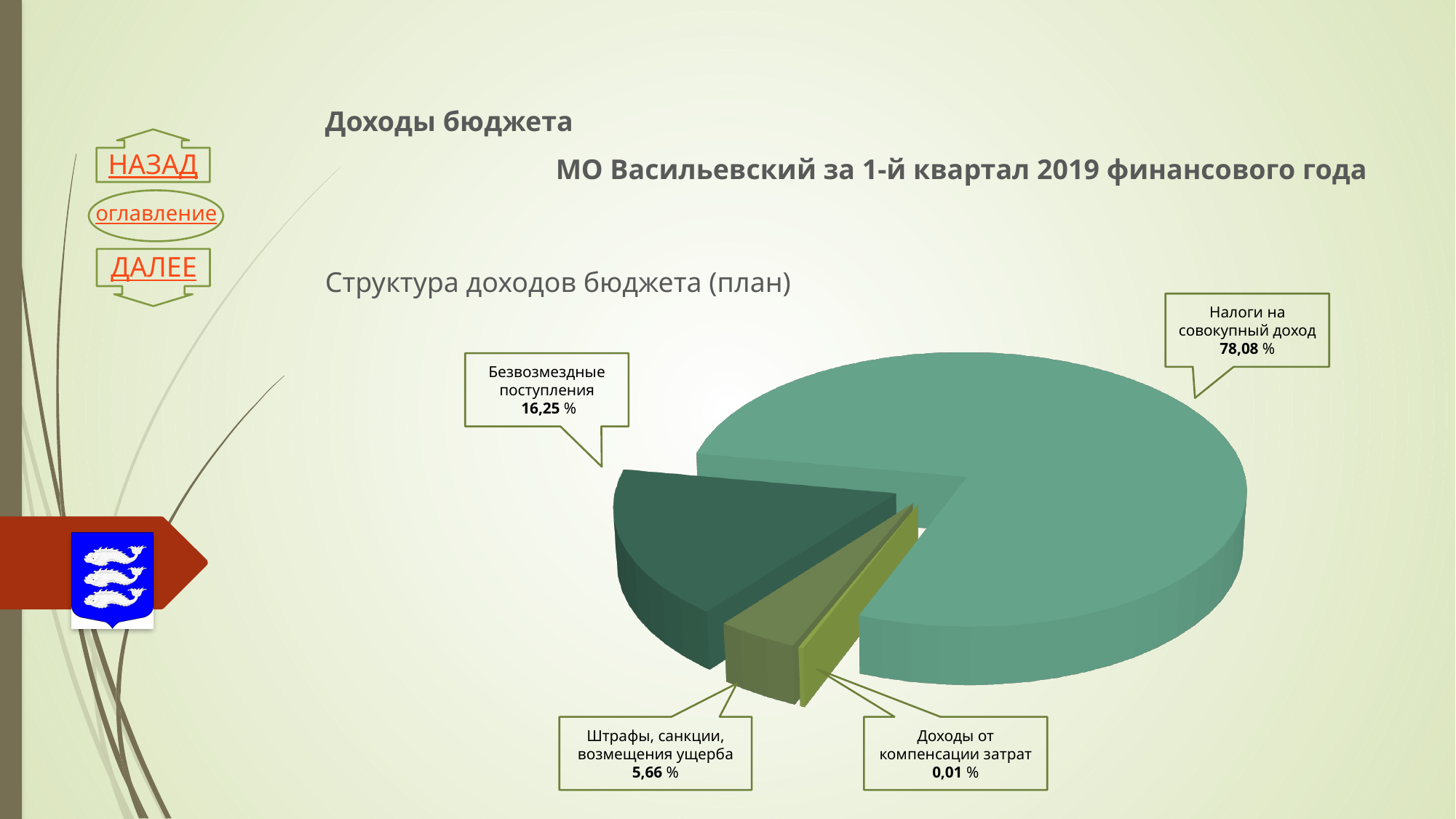
Which is larger: the share of "Безвозмездные поступления" or the share of "Штрафы, санкции, возмещения ущерба"? Безвозмездные поступления What is the share of "Безвозмездные поступления" in the pie chart? 16,25 % What is the share of "Налоги на совокупный доход" in the pie chart? 78,08 % What is the difference in percentage points between "Безвозмездные поступления" and "Штрафы, санкции, возмещения ущерба"? 10,59 What is the share of "Доходы от компенсации затрат" in the pie chart? 0,01 % What kind of chart is shown on the slide? pie chart What is the difference in percentage points between "Налоги на совокупный доход" and "Безвозмездные поступления"? 61,83 Which category has the largest slice in the pie chart? Налоги на совокупный доход Which category has the smallest slice in the pie chart? Доходы от компенсации затрат How many slices does the pie chart have? 4 What is the title of the chart on the slide? Структура доходов бюджета (план) What is the share of "Штрафы, санкции, возмещения ущерба" in the pie chart? 5,66 %